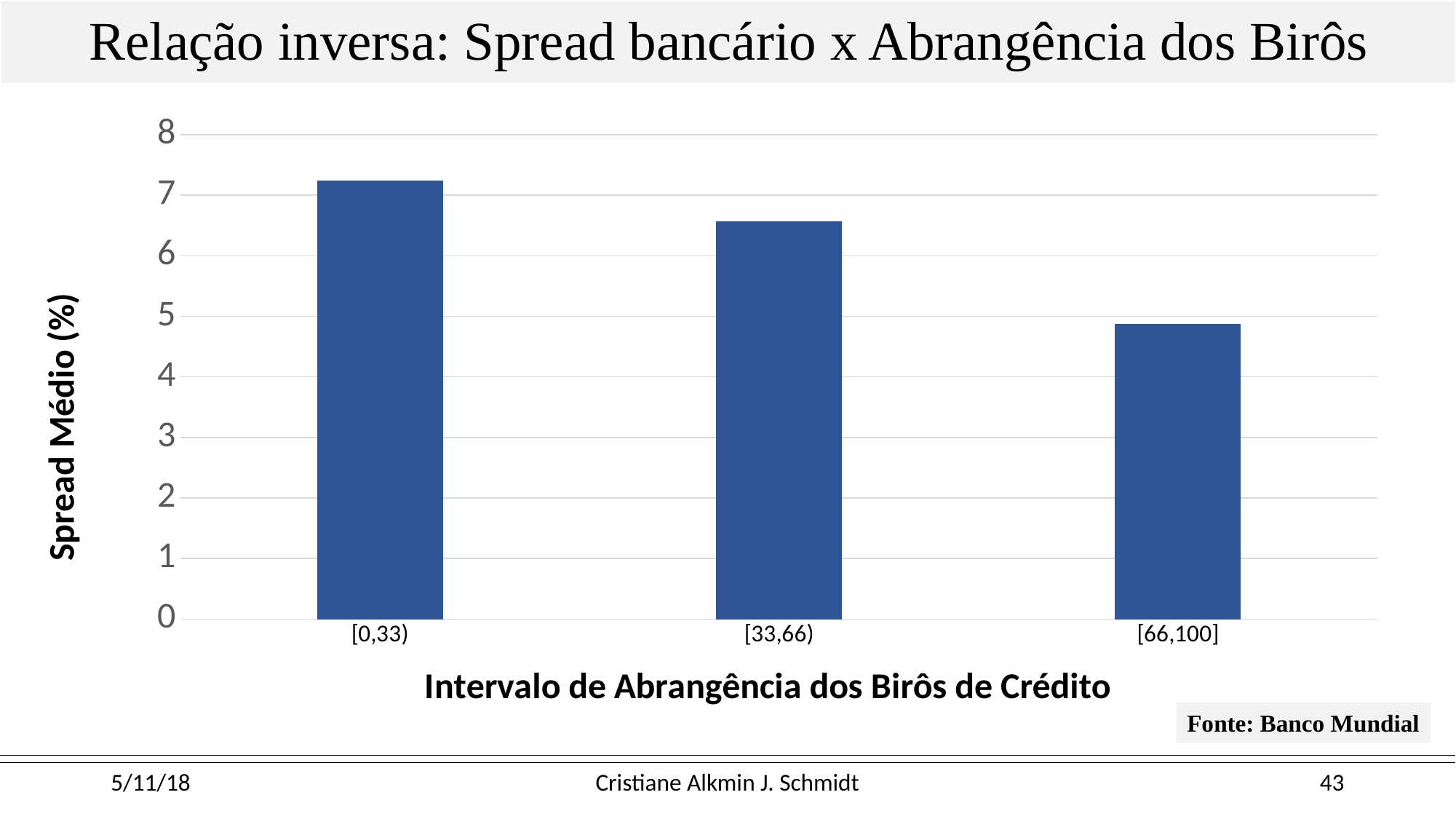
What kind of chart is shown on the slide? bar chart What is the label of the y axis? Spread Médio (%) Is the value for [33,66) greater or less than 6? greater Is the value for [0,33) greater or less than 7? greater Which interval has the highest average spread? [0,33) Do the values rise or fall as the coverage interval increases along the x axis? fall How many categories (intervals) are shown on the x axis? 3 Is the value for [66,100] greater or less than 4? greater Which interval has the lowest average spread? [66,100] Which is larger, the value for [33,66) or the value for [66,100]? [33,66)